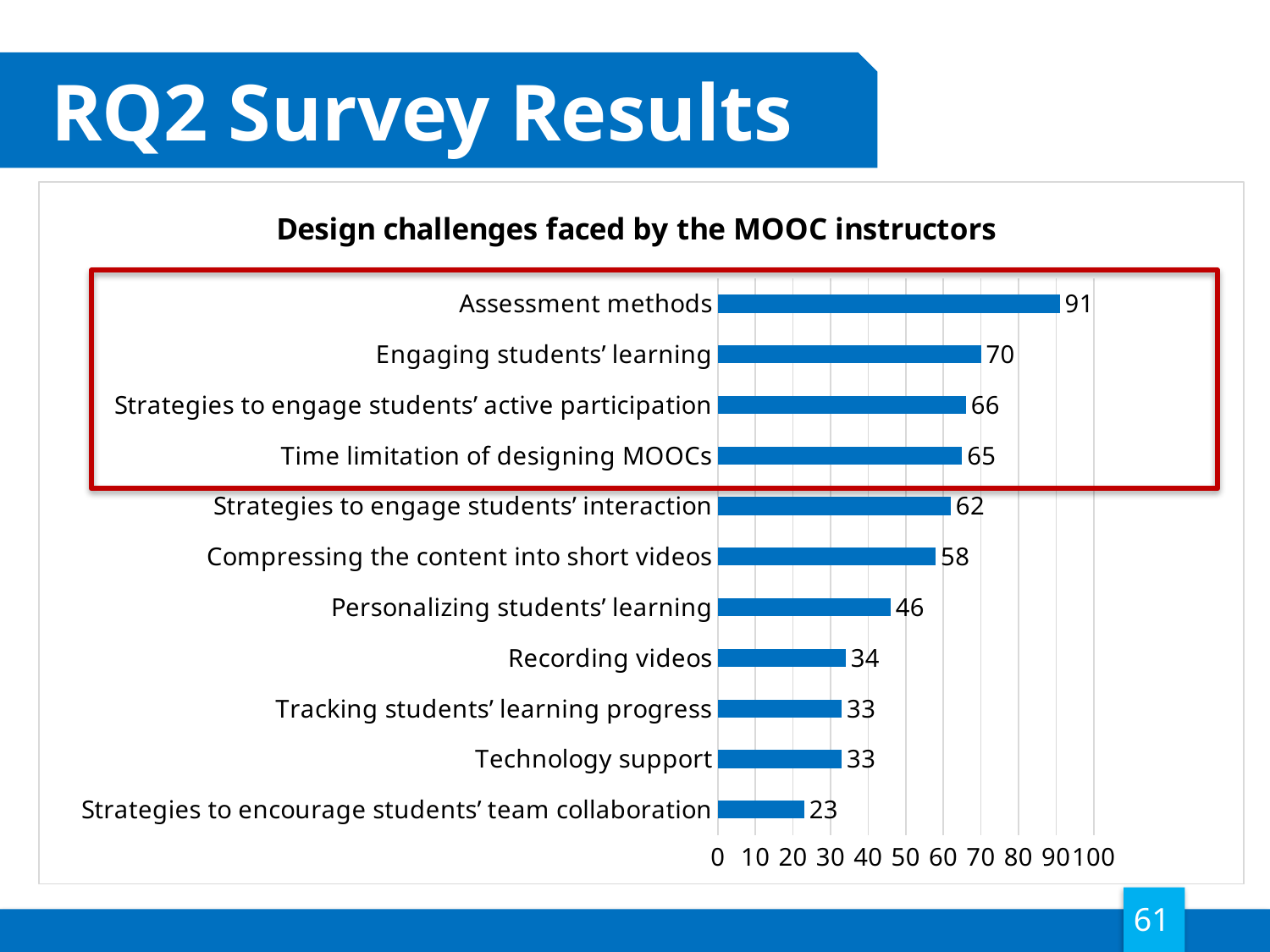
What is the difference between the values for Strategies to engage students' active participation and Time limitation of designing MOOCs? 1 What is the value for Compressing the content into short videos? 58 What is the value for Recording videos? 34 Which category has the highest value? Assessment methods What is the title of the chart? Design challenges faced by the MOOC instructors How many categories are shown in the chart? 11 What is the difference between the values for Assessment methods and Engaging students' learning? 21 Which category has the lowest value? Strategies to encourage students' team collaboration How many categories are enclosed by the red box on the chart? 4 What kind of chart is shown on the slide? Bar chart What is the value for Assessment methods? 91 Which is larger, the value for Personalizing students' learning or the value for Recording videos? Personalizing students' learning